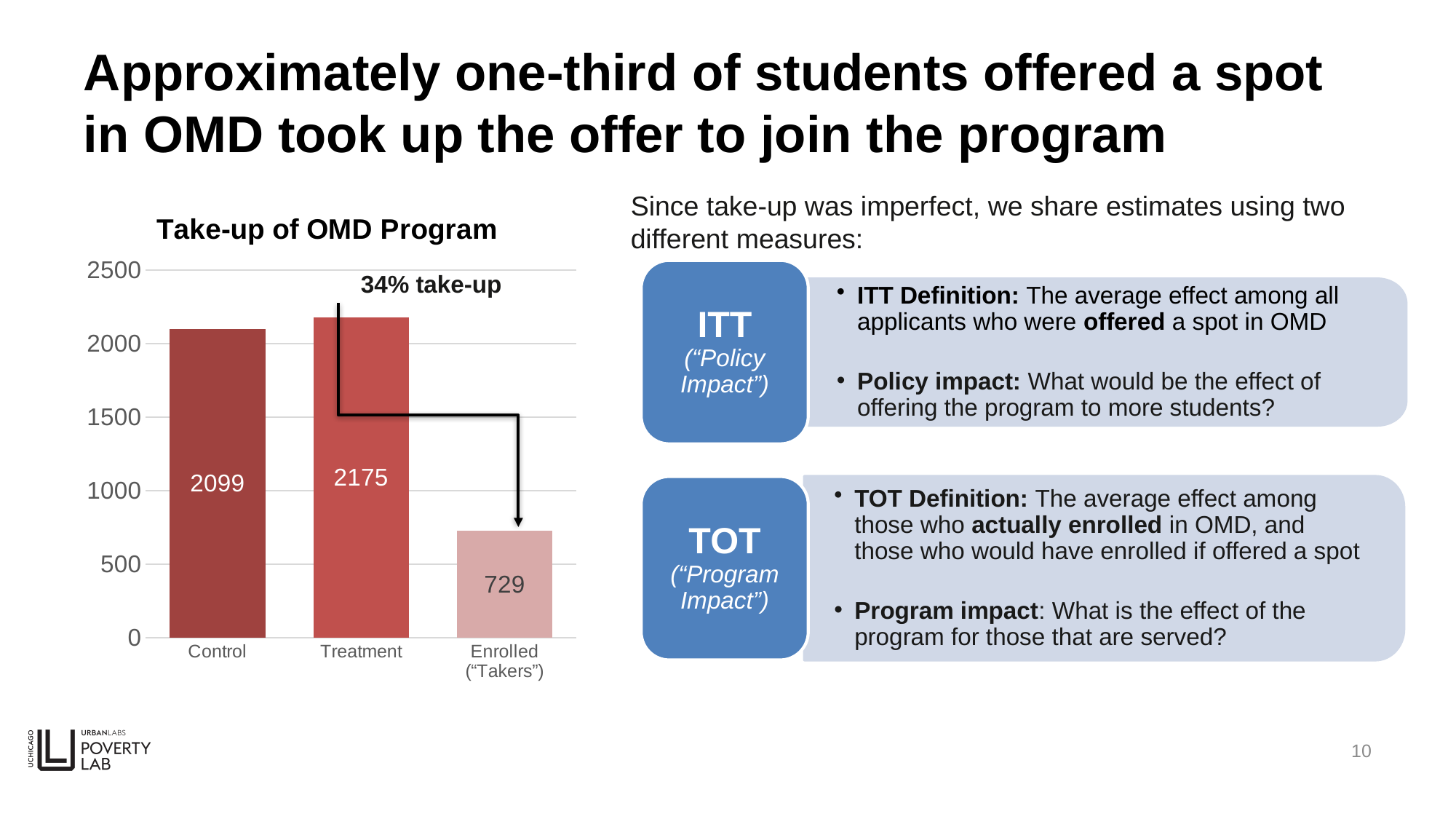
How many categories are shown in the Take-up of OMD Program chart? 3 Is the value for Enrolled ("Takers") greater or less than 1000? less What is the value for Enrolled ("Takers") in the Take-up of OMD Program chart? 729 What is the value for Control in the Take-up of OMD Program chart? 2099 What is the difference between the Treatment and Enrolled ("Takers") values in the Take-up of OMD Program chart? 1446 What is the value for Treatment in the Take-up of OMD Program chart? 2175 What take-up percentage is annotated on the Take-up of OMD Program chart? 34% take-up Which category has the lowest value in the Take-up of OMD Program chart? Enrolled ("Takers") What is the difference between the Treatment and Control values in the Take-up of OMD Program chart? 76 What kind of chart is the Take-up of OMD Program chart? bar chart Which category has the highest value in the Take-up of OMD Program chart? Treatment Which is larger in the Take-up of OMD Program chart, Control or Enrolled ("Takers")? Control